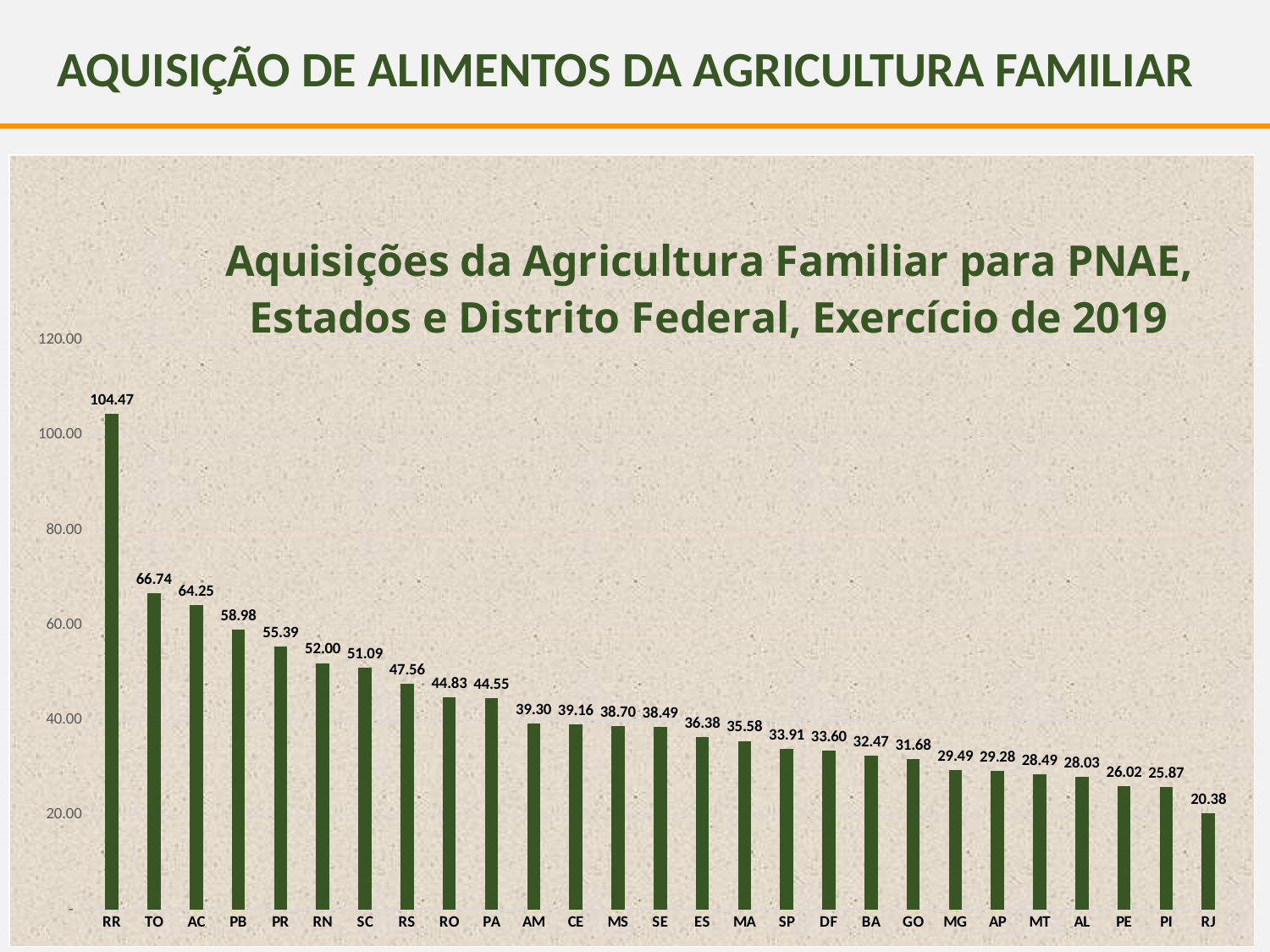
What is the value for MG? 29.49 What kind of chart is this? bar chart What is the difference between the values for SP and RJ? 13.53 What is the value for SP? 33.91 Which has a larger value, PB or BA? PB How many states/units are shown on the x axis? 27 Which state has the highest value? RR What is the difference between the values for RR and TO? 37.73 Is the value for PR greater or less than 60.00? less Which state has the lowest value? RJ Do the values rise or fall from left to right along the x axis? fall What is the value for RR? 104.47